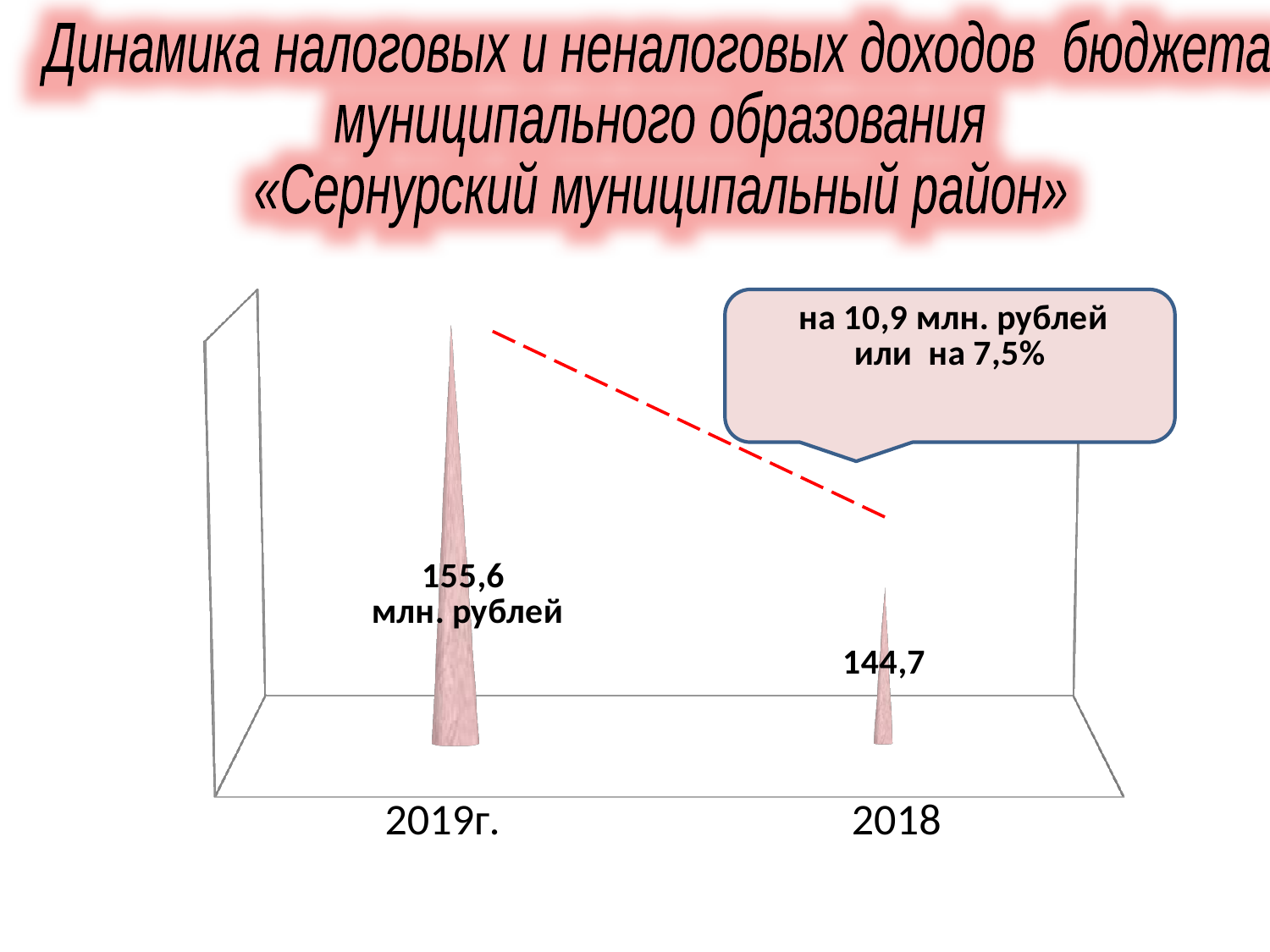
What is the difference between the 2019г. value and the 2018 value? 10,9 What kind of chart is shown on the slide? bar chart Is the value for 2019г. larger or smaller than the value for 2018? larger How many categories are plotted on the chart? 2 Do the values rise or fall moving left to right along the x axis, from 2019г. to 2018? fall What percentage change is stated in the callout on the chart? 7,5% Which municipal district is named in the slide title? Сернурский муниципальный район What is the value shown for 2019г.? 155,6 млн. рублей Which year has the lower value? 2018 What is the value shown for 2018? 144,7 Which year has the higher value? 2019г.